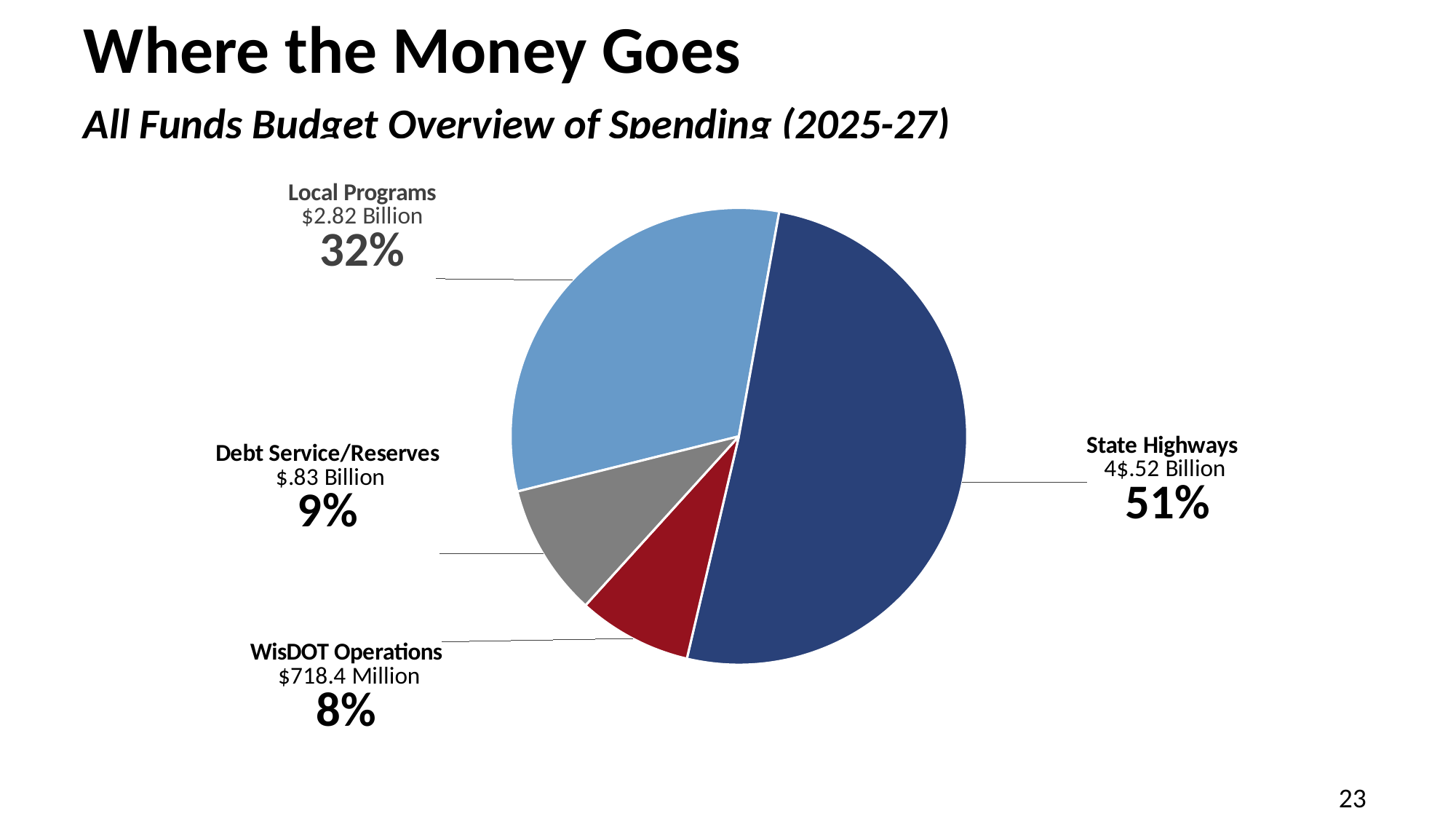
Which category has the largest share of spending? State Highways What percentage share does Local Programs have? 32% Which category has the smallest share of spending? WisDOT Operations What is the difference in percentage points between State Highways and Local Programs? 19 percentage points What type of chart is shown on the slide? Pie chart What percentage share does WisDOT Operations have? 8% What percentage share does State Highways have? 51% What is the subtitle of the chart on the slide? All Funds Budget Overview of Spending (2025-27) What dollar amount is shown for Local Programs? $2.82 Billion How many categories are shown in the pie chart? 4 What dollar amount is shown for WisDOT Operations? $718.4 Million